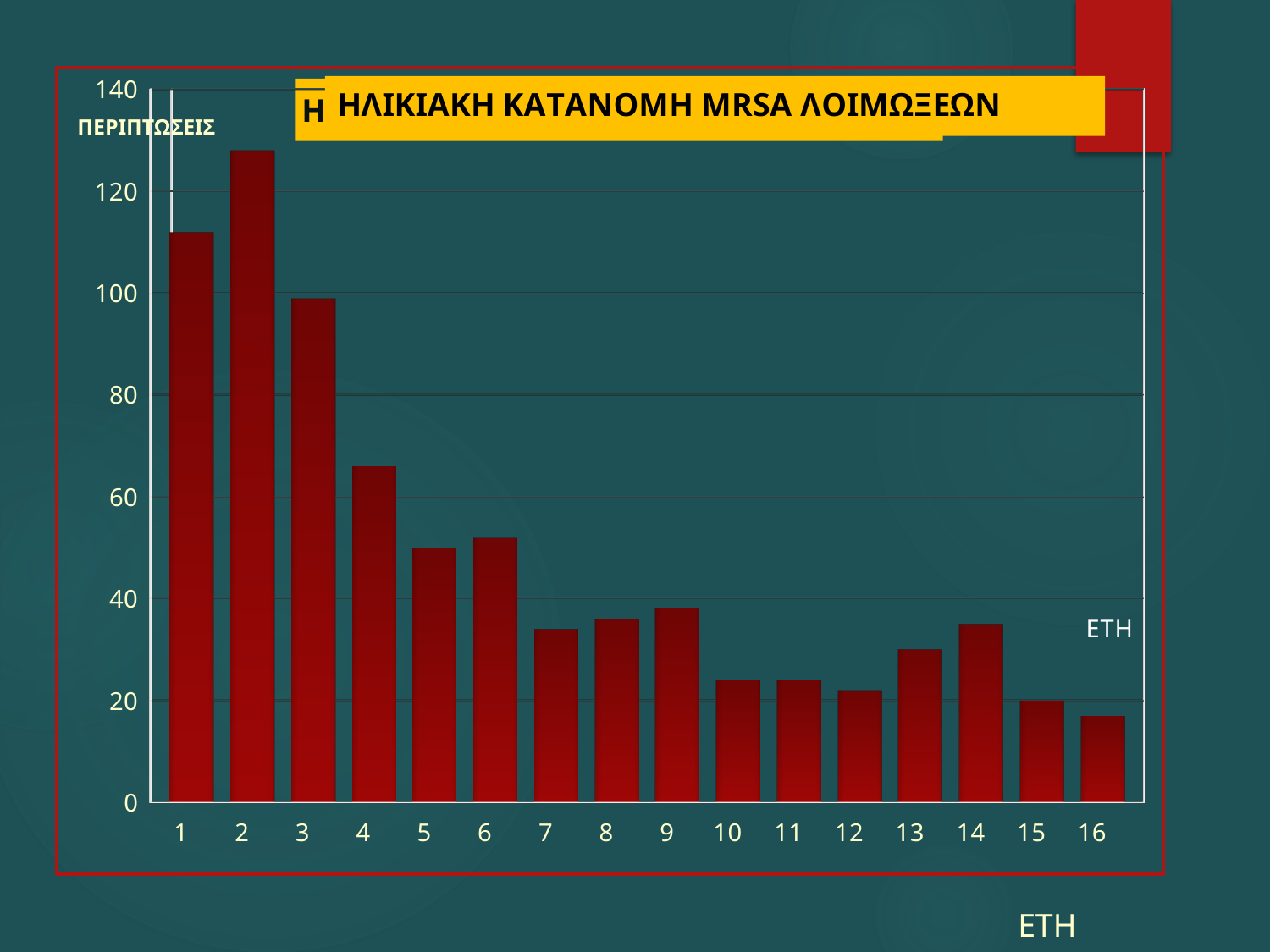
How many categories are shown on the x axis of the chart? 16 Is the value for category 2 greater or less than 120? greater Which category has the lowest bar in the chart? 16 Is the value for category 4 greater or less than 60? greater Which category has the highest bar in the chart? 2 What is the title of the chart? ΗΛΙΚΙΑΚΗ ΚΑΤΑΝΟΜΗ MRSA ΛΟΙΜΩΞΕΩΝ Which is larger, the value for category 13 or the value for category 12? 13 Do the values generally rise or fall from category 1 to category 16? fall What kind of chart is shown on the slide? bar chart Which is larger, the value for category 4 or the value for category 5? 4 Is the value for category 16 greater or less than 20? less